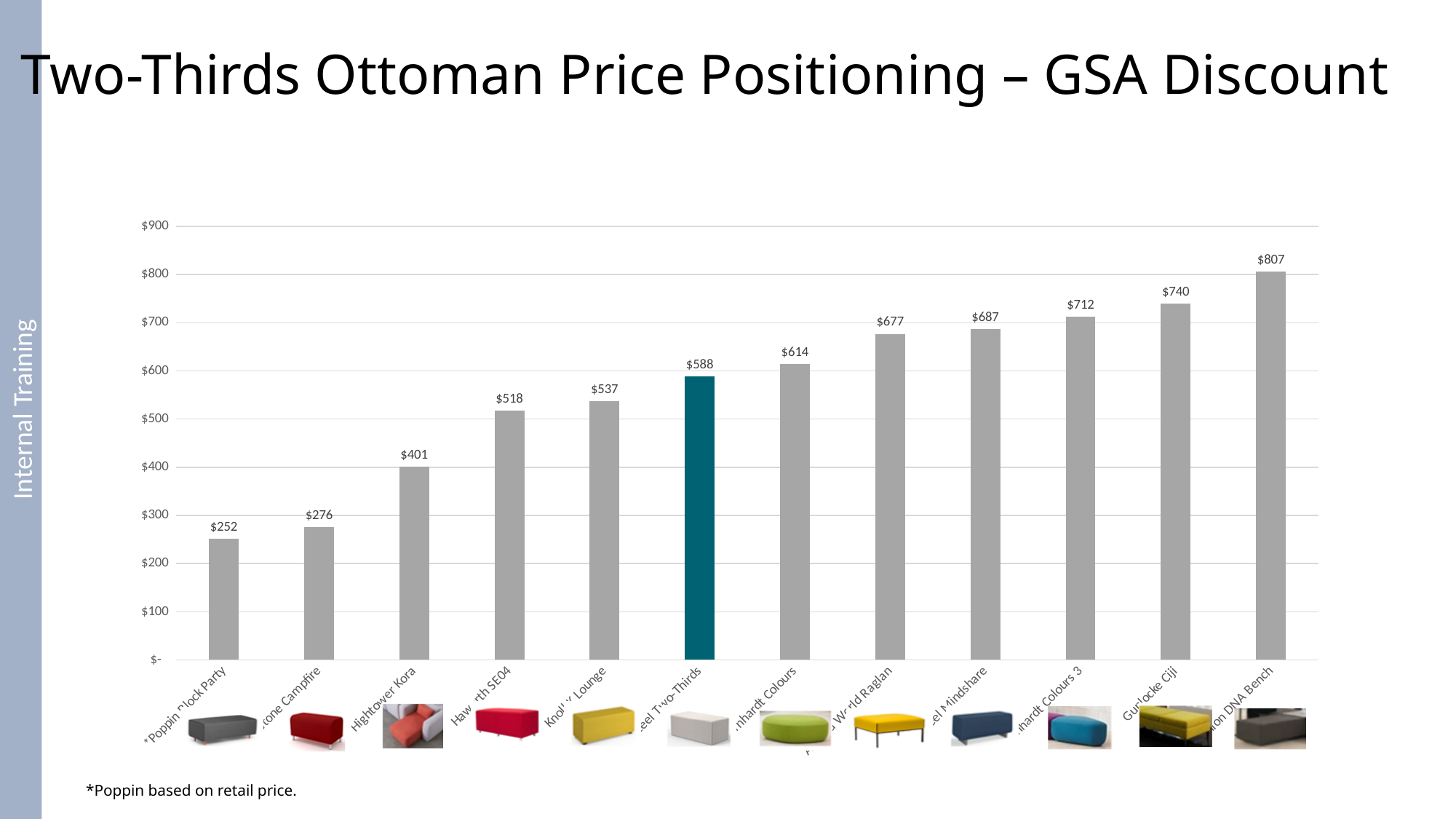
What is the value for Gunlocke Ciji? $740 What is the value for Hightower Kora? $401 Which has a larger value, Hightower Kora or the highlighted Two-Thirds bar? Two-Thirds What is the lowest value shown in the chart? $252 How many bars (products) are plotted in the chart? 12 What is the difference between the values for Gunlocke Ciji and Hightower Kora? $339 What is the title of the slide containing the chart? Two-Thirds Ottoman Price Positioning – GSA Discount Do the values rise or fall from left to right across the chart? Rise What is the value of the highlighted (teal) Two-Thirds bar? $588 What kind of chart is shown on the slide? Bar chart What is the highest value shown in the chart? $807 What is the difference between the highest and lowest values in the chart? $555